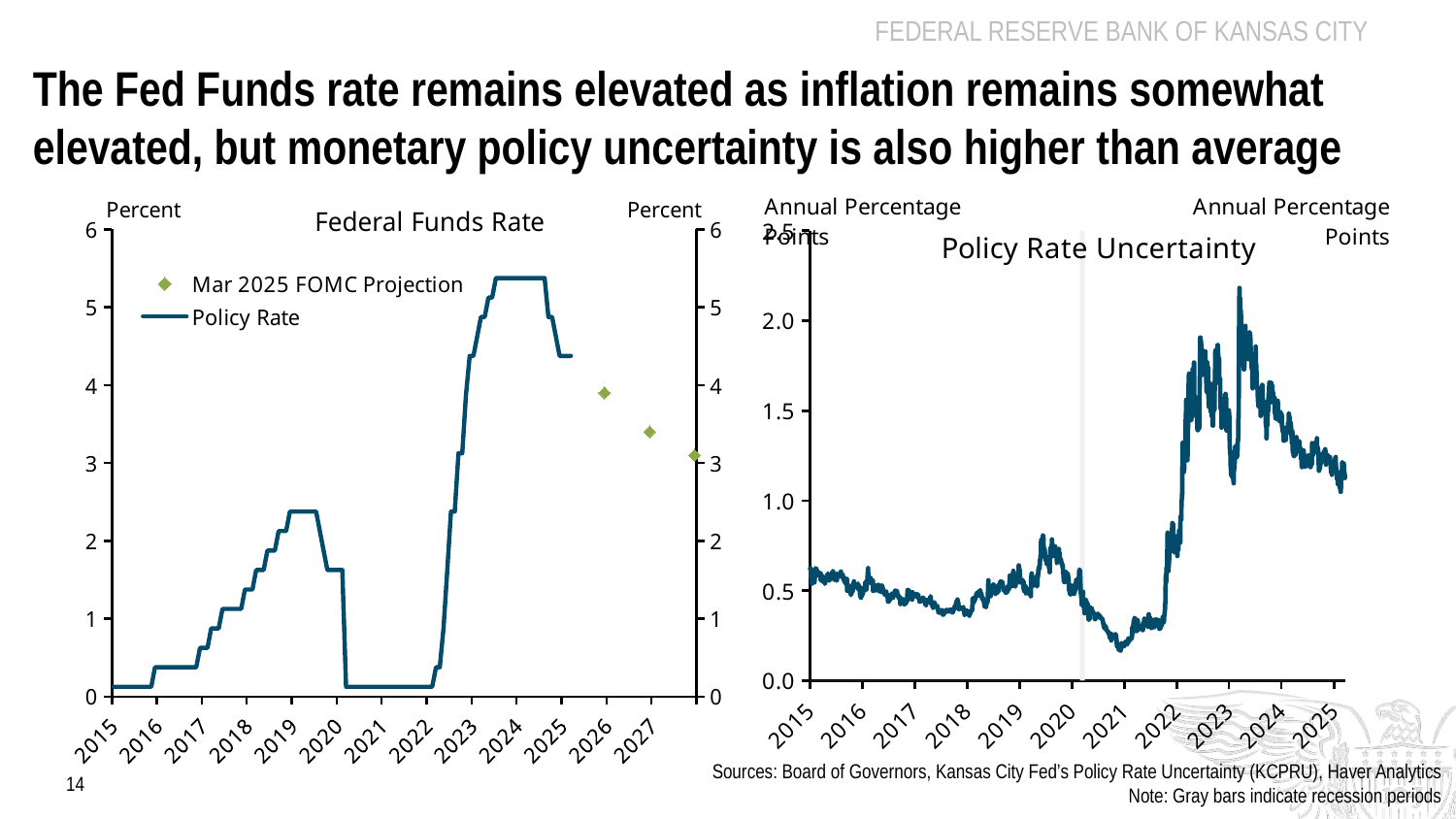
In the Federal Funds Rate chart, is the Mar 2025 FOMC Projection for 2027 greater or less than 4 percent? less What kind of chart is the Federal Funds Rate chart on the left? line chart In the Federal Funds Rate chart, is the Policy Rate in 2021 greater or less than 1 percent? less In the Policy Rate Uncertainty chart, is the peak value reached in 2023 greater or less than 2.0 annual percentage points? greater In the Federal Funds Rate chart, does the Policy Rate rise or fall between 2022 and 2023? rise In the Policy Rate Uncertainty chart, does the value rise or fall between 2023 and 2025? fall In the Federal Funds Rate chart, what are the two entries in the legend? Mar 2025 FOMC Projection and Policy Rate In the Federal Funds Rate chart, how many Mar 2025 FOMC Projection points are plotted? 3 How many series does the legend of the Federal Funds Rate chart list? 2 What is the title of the chart on the right side of the slide? Policy Rate Uncertainty